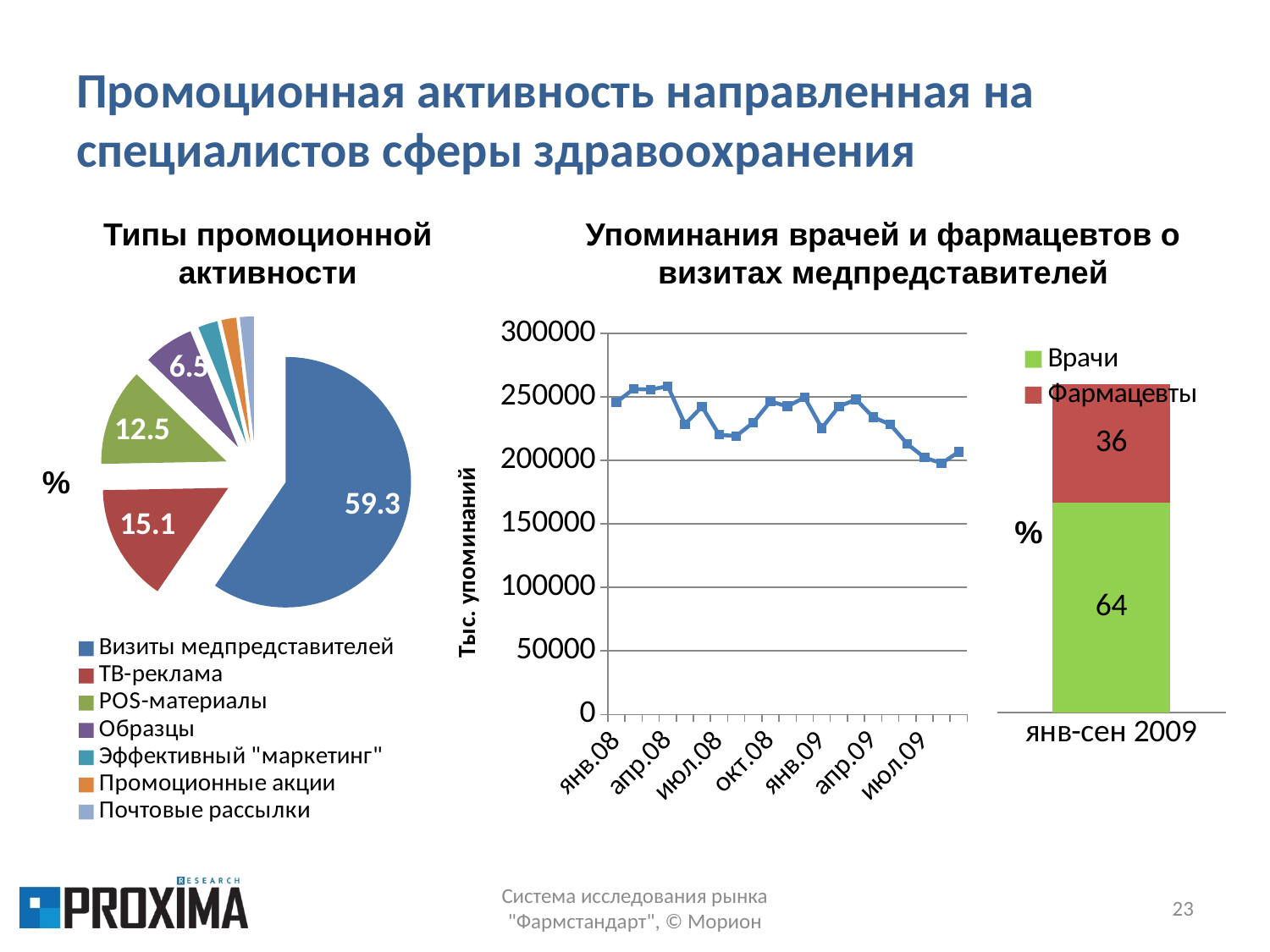
In the pie chart 'Типы промоционной активности', what is the value for ТВ-реклама? 15.1 In the stacked bar chart on the right, what is the total of the bar for янв-сен 2009? 100 In the pie chart 'Типы промоционной активности', what is the difference between the values for ТВ-реклама and POS-материалы? 2.6 In the line chart under 'Упоминания врачей и фармацевтов о визитах медпредставителей', is the value for янв.08 greater or less than 200000? greater In the pie chart 'Типы промоционной активности', which is larger: Образцы or POS-материалы? POS-материалы In the pie chart 'Типы промоционной активности', which category has the largest slice? Визиты медпредставителей In the stacked bar chart on the right for янв-сен 2009, what is the value for Врачи? 64 In the pie chart 'Типы промоционной активности', what is the value for POS-материалы? 12.5 In the pie chart 'Типы промоционной активности', how many categories does the legend list? 7 In the stacked bar chart on the right for янв-сен 2009, what is the value for Фармацевты? 36 In the line chart under 'Упоминания врачей и фармацевтов о визитах медпредставителей', do the values generally rise or fall from янв.08 to июл.09? fall In the pie chart 'Типы промоционной активности', what is the value for Визиты медпредставителей? 59.3